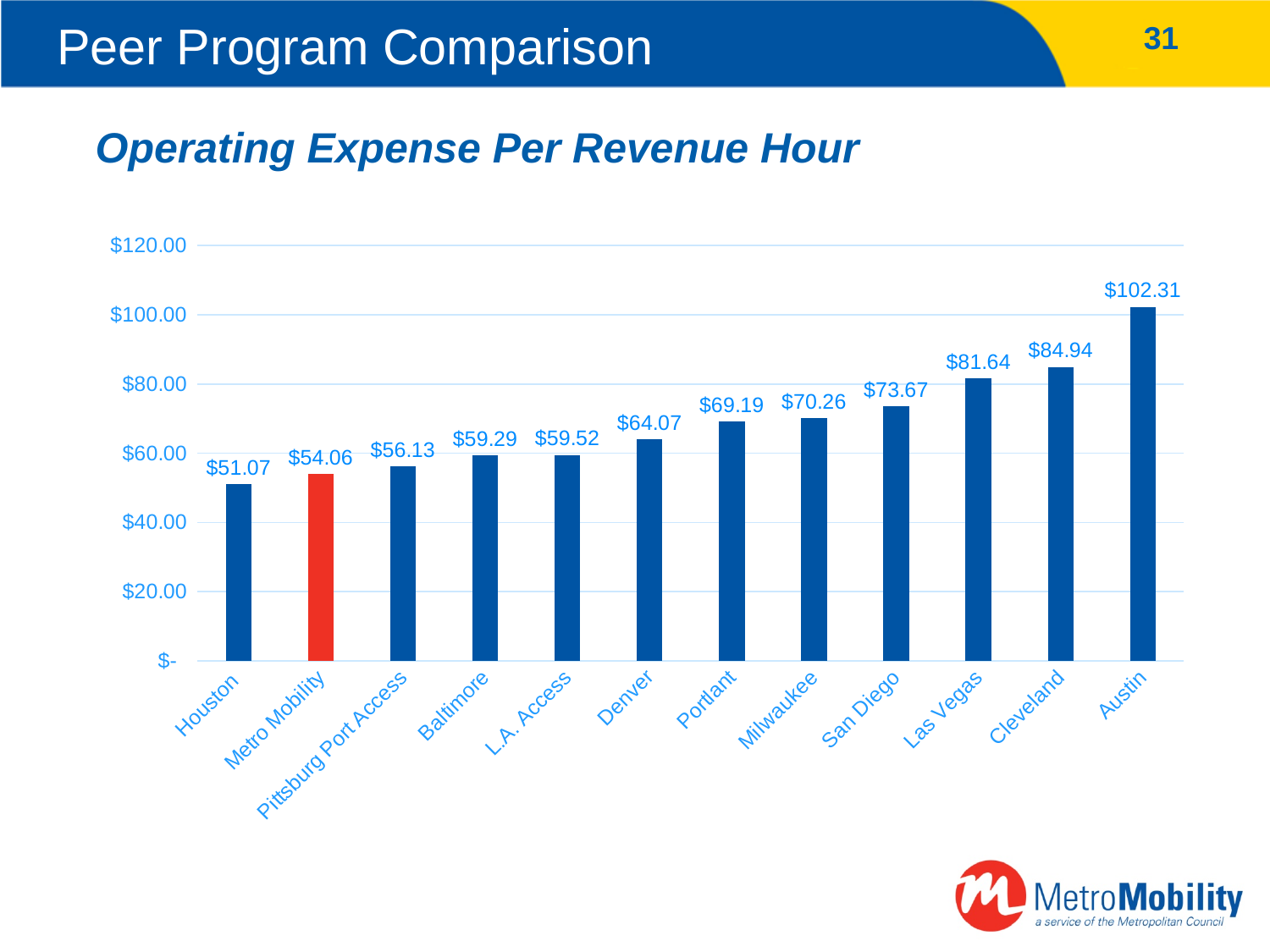
How many programs are shown in the chart? 12 Is the value for Milwaukee greater or less than $80.00? less What is the operating expense per revenue hour for Metro Mobility? $54.06 What is the operating expense per revenue hour for Denver? $64.07 What is the difference between Austin's and Houston's operating expense per revenue hour? $51.24 What is the difference between Metro Mobility's and Las Vegas's operating expense per revenue hour? $27.58 What kind of chart is shown on the slide? Bar chart What is the operating expense per revenue hour for Cleveland? $84.94 Which bar is highlighted in red? Metro Mobility Which program has the highest operating expense per revenue hour? Austin Which has a higher operating expense per revenue hour, Portland or San Diego? San Diego Which program has the lowest operating expense per revenue hour? Houston